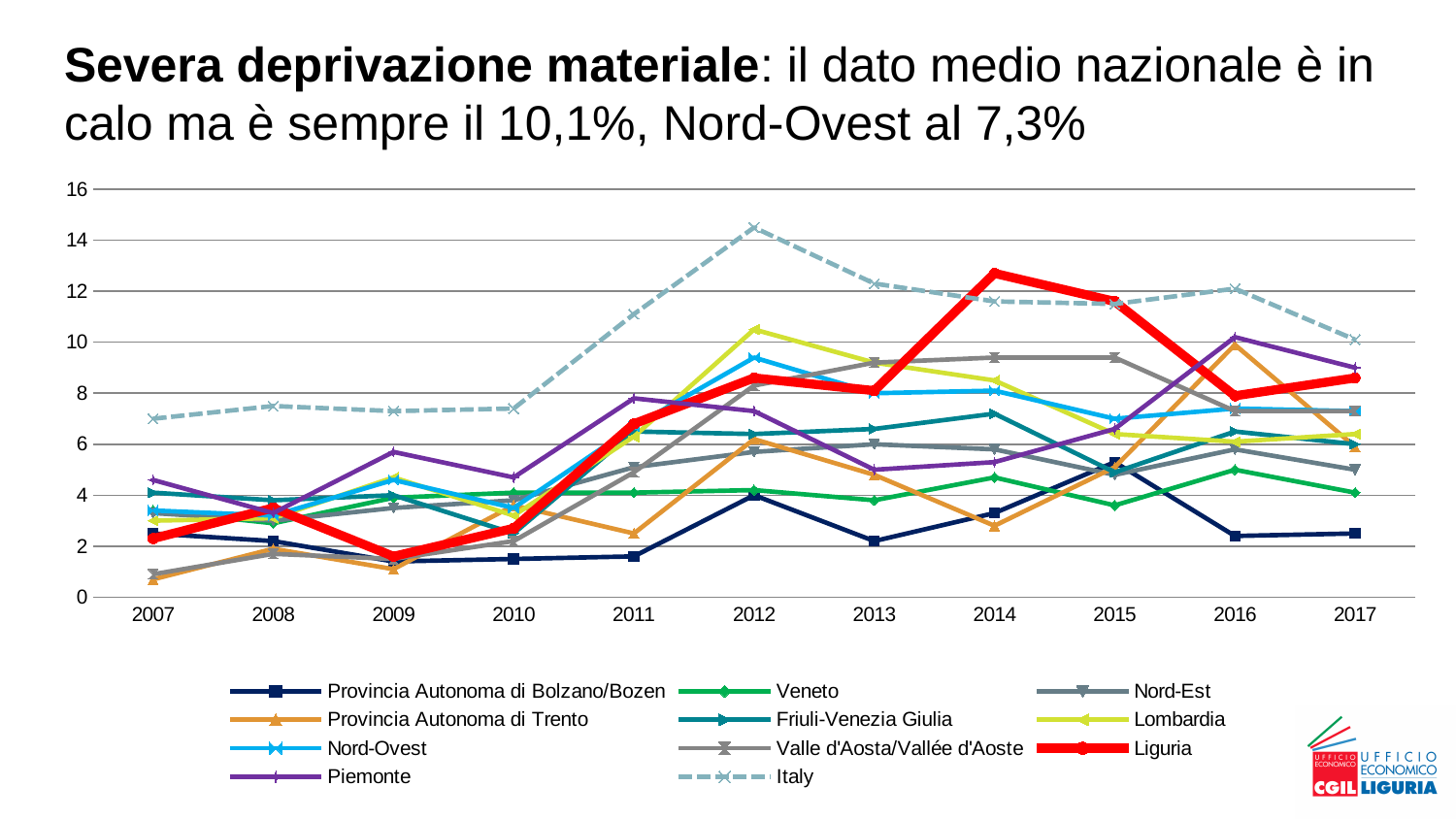
Is the value for Italy in 2012 greater or less than 12? greater Is the value for Liguria in 2009 greater or less than 2? less Which series has the lowest value in 2013? Provincia Autonoma di Bolzano/Bozen Which series has the highest value in 2014? Liguria In 2014, which is larger: the value for Liguria or the value for Italy? Liguria What kind of chart is shown on the slide? line chart Which series is drawn with a dashed line? Italy How many series does the legend list? 11 Is the value for Liguria in 2014 greater or less than 12? greater How many years are shown along the x axis? 11 Which series has the highest value in 2012? Italy Does the Italy series rise or fall from 2012 to 2013? fall